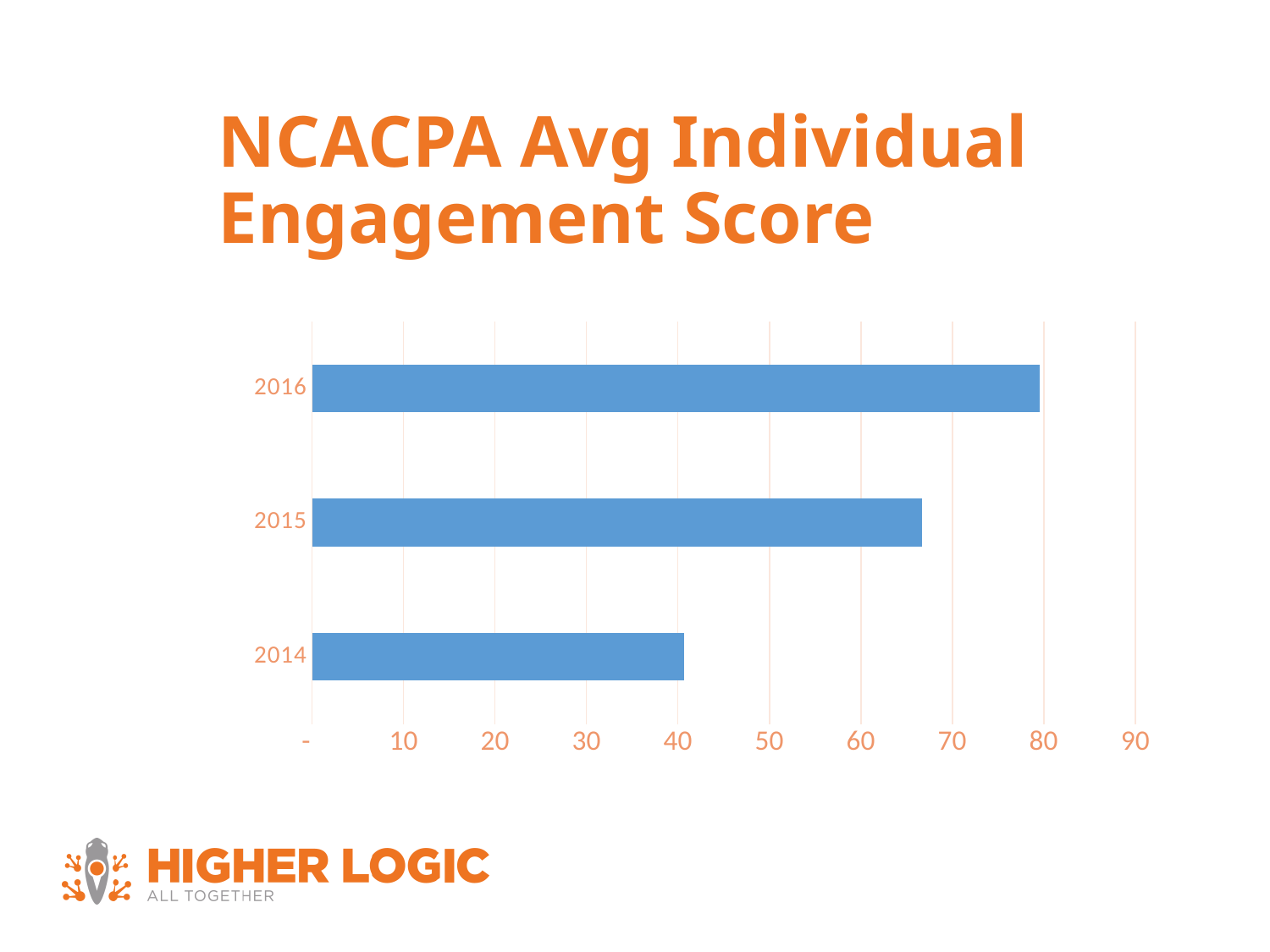
Is the value for 2014 greater or less than 50? less Is the value for 2016 greater or less than 70? greater Do the engagement scores rise or fall from 2014 to 2016? rise Which year has the lowest average individual engagement score? 2014 Which is larger, the value for 2015 or the value for 2014? 2015 Is the value for 2015 greater or less than 70? less What kind of chart is shown on the slide? bar chart Which year has the highest average individual engagement score? 2016 How many years are plotted in the chart? 3 What is the title shown above the chart? NCACPA Avg Individual Engagement Score Which is larger, the value for 2016 or the value for 2015? 2016